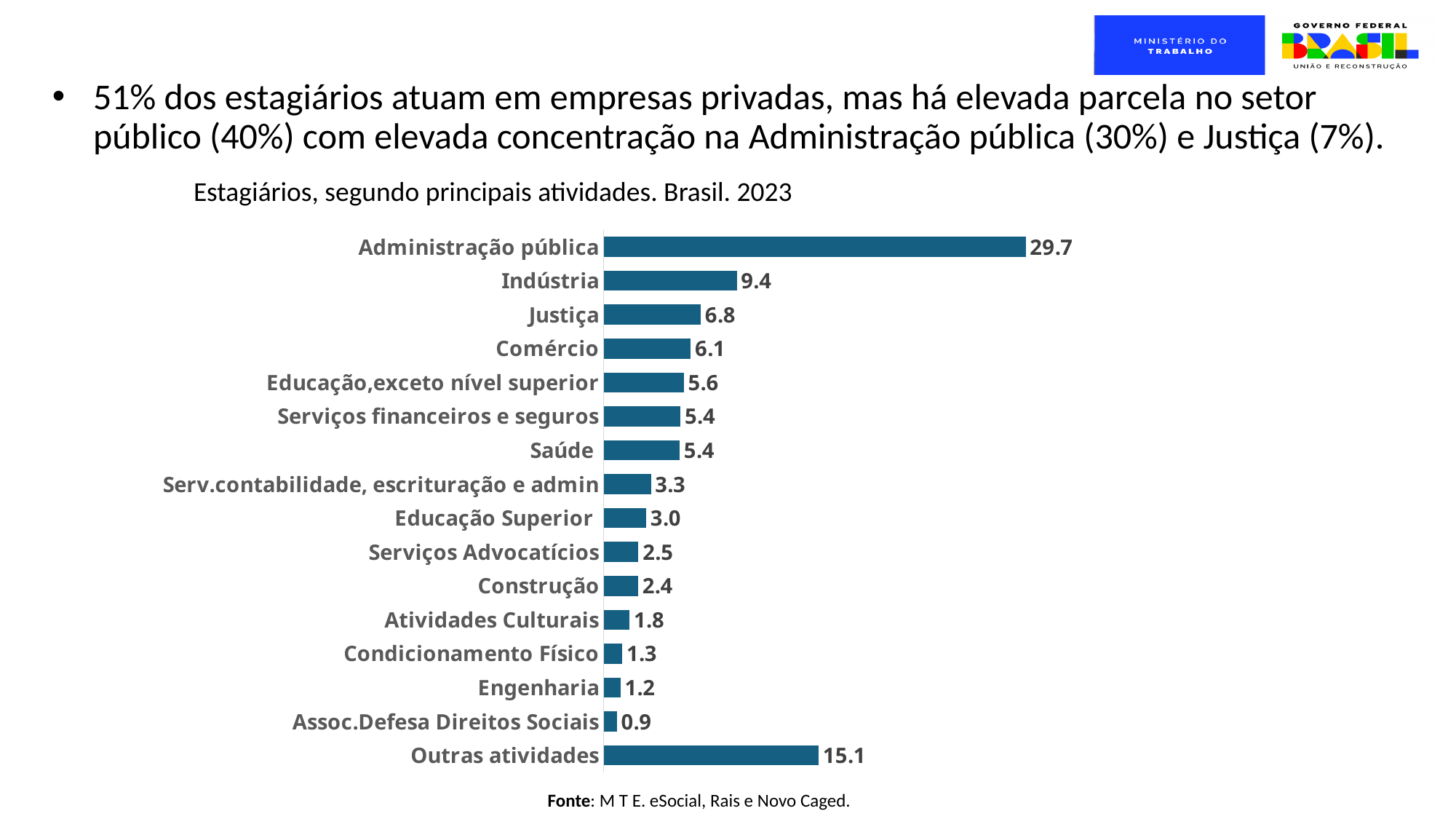
What is the difference between the values for Justiça and Comércio? 0.7 Which category has the lowest value? Assoc.Defesa Direitos Sociais What is the value for Indústria? 9.4 How many categories are shown in the chart? 16 What kind of chart is shown on the slide? Bar chart Which is larger, the value for Construção or the value for Atividades Culturais? Construção What is the title of the chart? Estagiários, segundo principais atividades. Brasil. 2023 What is the value for Outras atividades? 15.1 What is the difference between the values for Administração pública and Indústria? 20.3 Which category has the highest value? Administração pública What is the value for Engenharia? 1.2 What is the value for Administração pública? 29.7